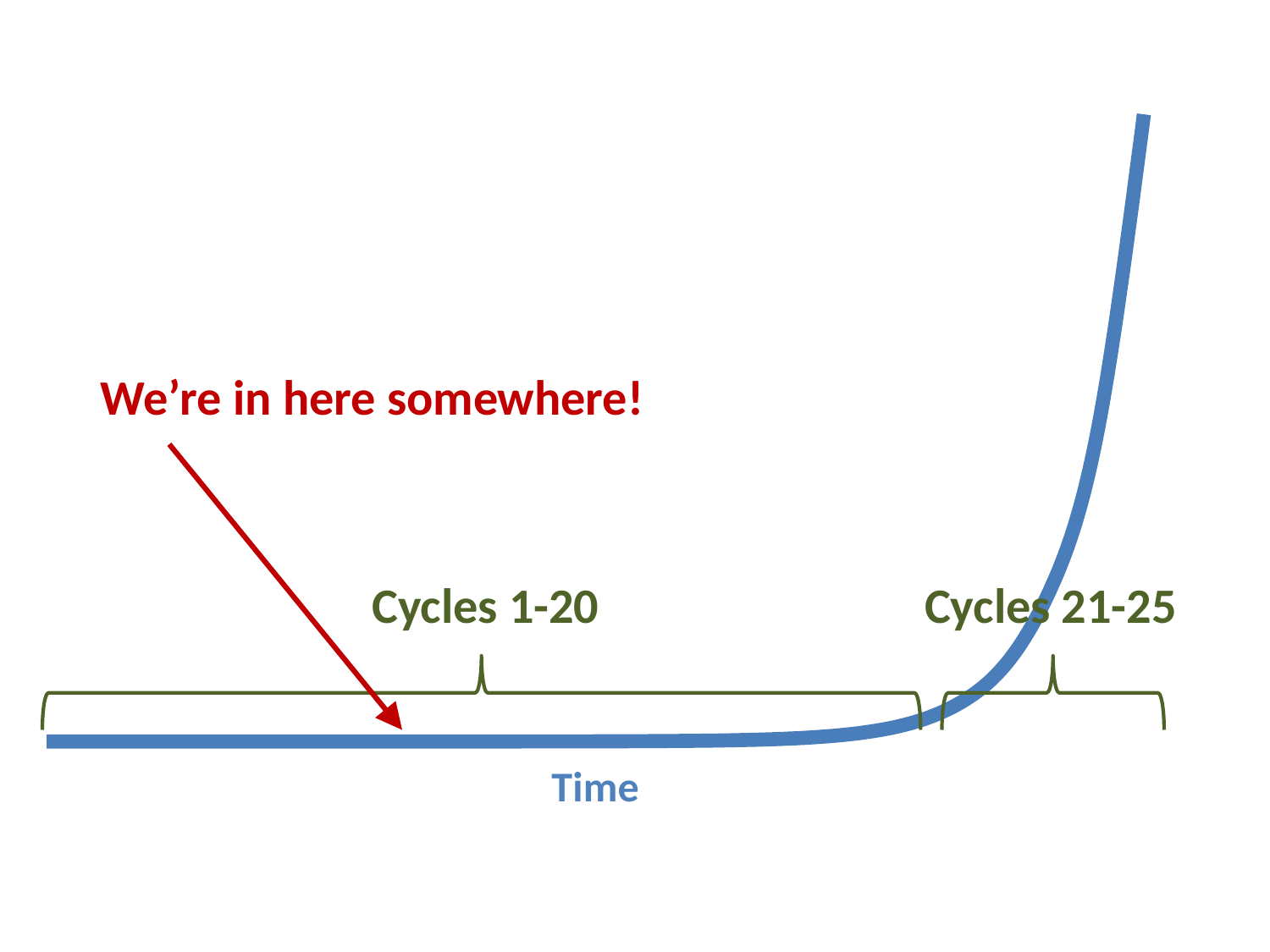
How many lines are plotted on the chart? 1 Which labelled cycle range does the red arrow reading "We're in here somewhere!" point to? Cycles 1-20 In which labelled range of cycles does the line rise most steeply? Cycles 21-25 How many labelled cycle ranges are marked with brackets along the x axis? 2 Does the plotted line rise or fall as it moves along the x axis from left to right? rise What is the label on the x axis of the chart? Time What kind of chart is shown on the slide? line chart